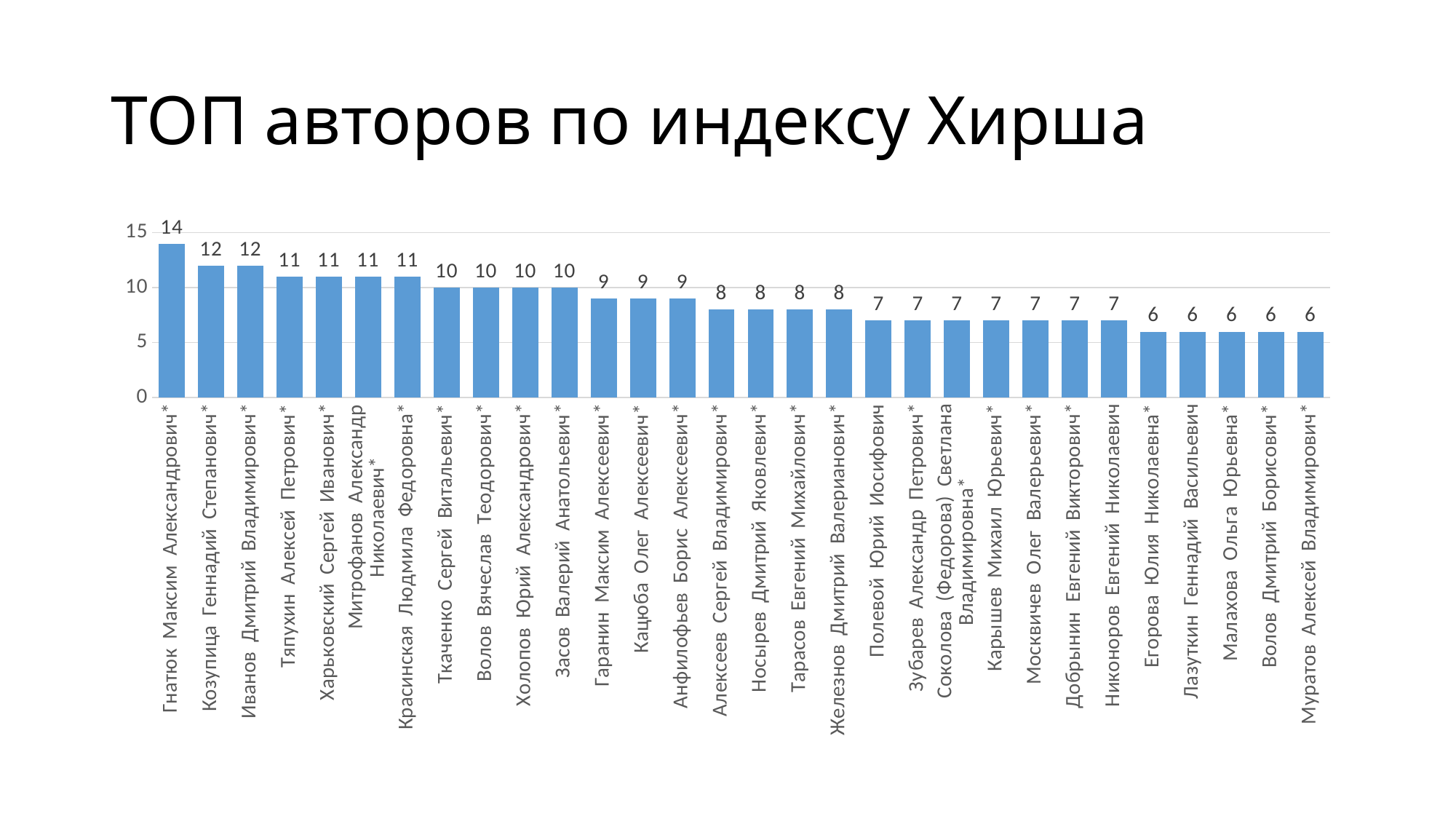
Which is larger: the value for Гаранин Максим Алексеевич or the value for Алексеев Сергей Владимирович? Гаранин Максим Алексеевич What kind of chart is shown on the slide? bar chart What is the value for Муратов Алексей Владимирович? 6 Is the value for Тарасов Евгений Михайлович greater or less than 10? less What is the value for Ткаченко Сергей Витальевич? 10 How many authors are shown in the chart? 30 Which author has the highest value? Гнатюк Максим Александрович What is the difference between the values for Засов Валерий Анатольевич and Егорова Юлия Николаевна? 4 What is the value for Гнатюк Максим Александрович? 14 Do the values rise or fall from left to right along the x axis? fall What is the value for Полевой Юрий Иосифович? 7 What is the difference between the values for Гнатюк Максим Александрович and Козупица Геннадий Степанович? 2